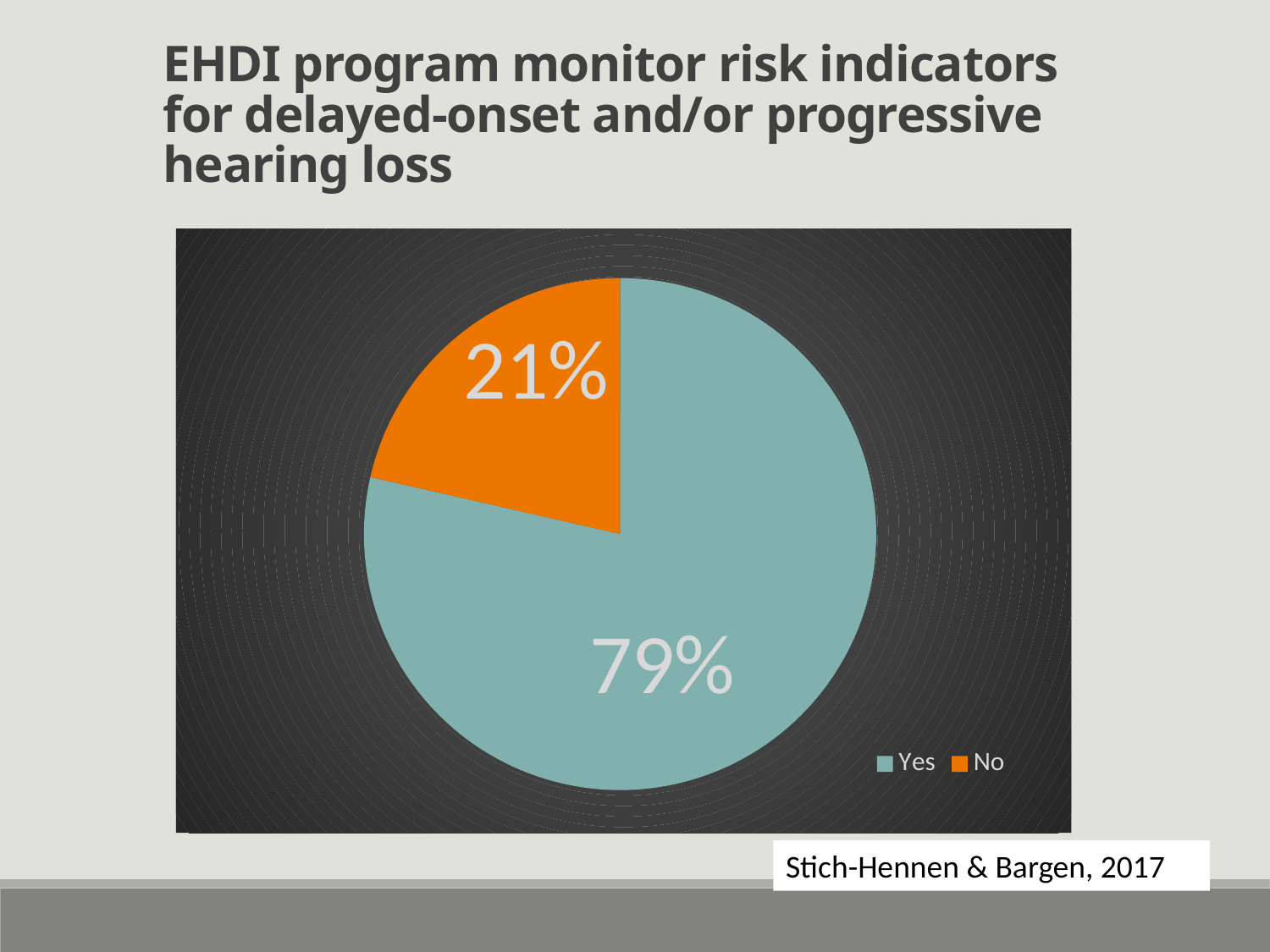
What percentage of the pie is labelled "No"? 21% What type of chart is shown on the slide? pie chart How many entries does the legend list? 2 What share of the pie does the "No" slice represent? 21% What source is cited below the chart? Stich-Hennen & Bargen, 2017 What is the difference in percentage points between the "Yes" and "No" slices? 58 How many slices does the pie chart have? 2 Which slice is larger, "Yes" or "No"? Yes Which slice is the smallest in the pie chart? No What colour is the "No" slice in the pie chart? orange What percentage of the pie is labelled "Yes"? 79% Which slice is the largest in the pie chart? Yes